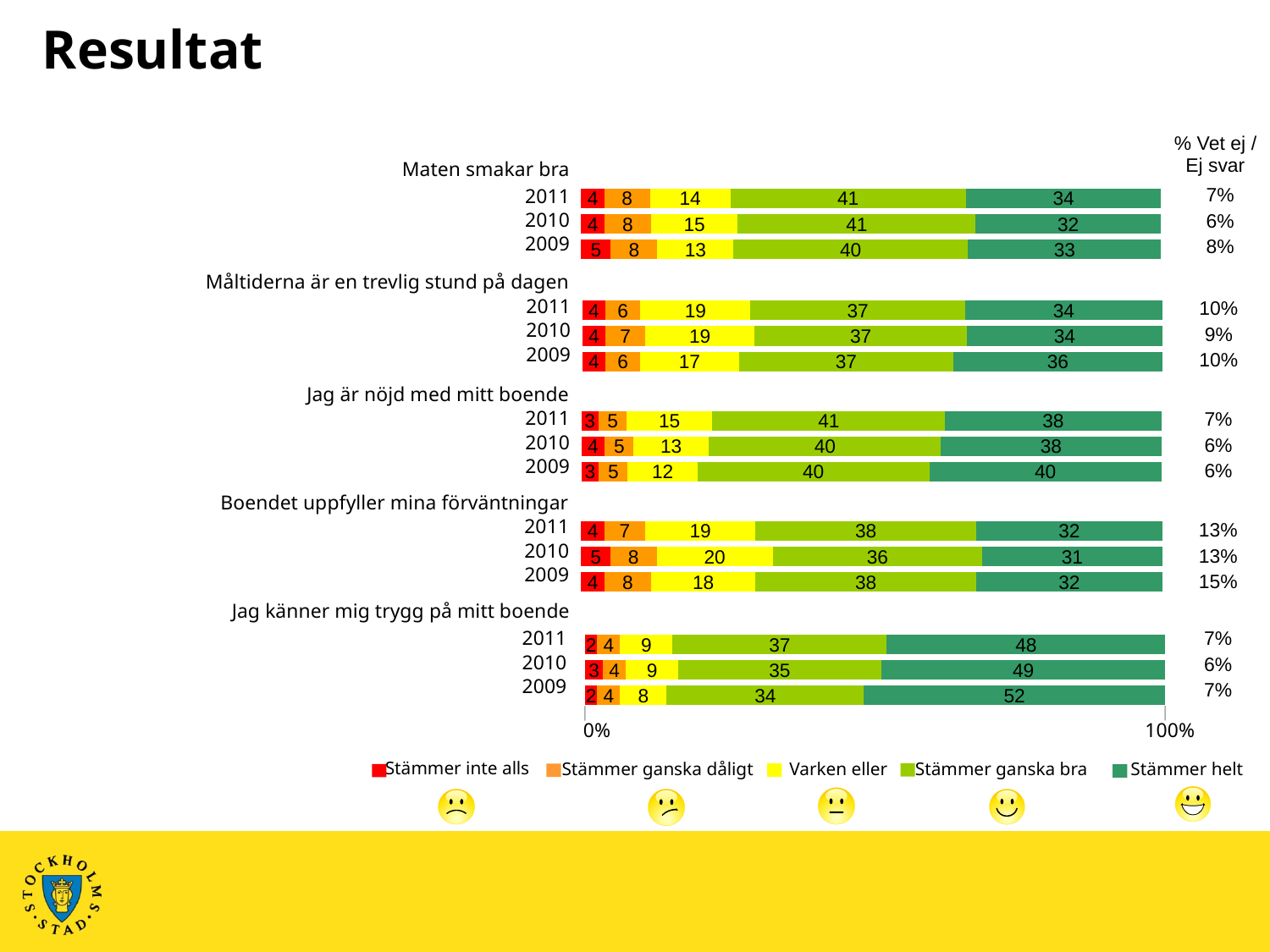
What is the difference between the "Varken eller" values for "Måltiderna är en trevlig stund på dagen" in 2011 and 2009? 2 For "Jag känner mig trygg på mitt boende", which year has the highest "Stämmer helt" value? 2009 What is the value of "Varken eller" for "Boendet uppfyller mina förväntningar" in 2010? 20 What is the value of "Stämmer ganska bra" for "Maten smakar bra" in 2011? 41 What is the value of "Stämmer helt" for "Jag känner mig trygg på mitt boende" in 2009? 52 What kind of chart is shown on the slide? Stacked bar chart How many statements are shown in the chart? 5 How many series does the legend list? 5 For "Jag är nöjd med mitt boende", is the "Stämmer helt" value larger in 2009 or in 2011? 2009 Across all bars in the chart, which statement and year has the lowest "Stämmer helt" value? Boendet uppfyller mina förväntningar, 2010 What is the total of the stacked bar for "Jag känner mig trygg på mitt boende" in 2009? 100 What is the "% Vet ej / Ej svar" value for "Boendet uppfyller mina förväntningar" in 2009? 15%